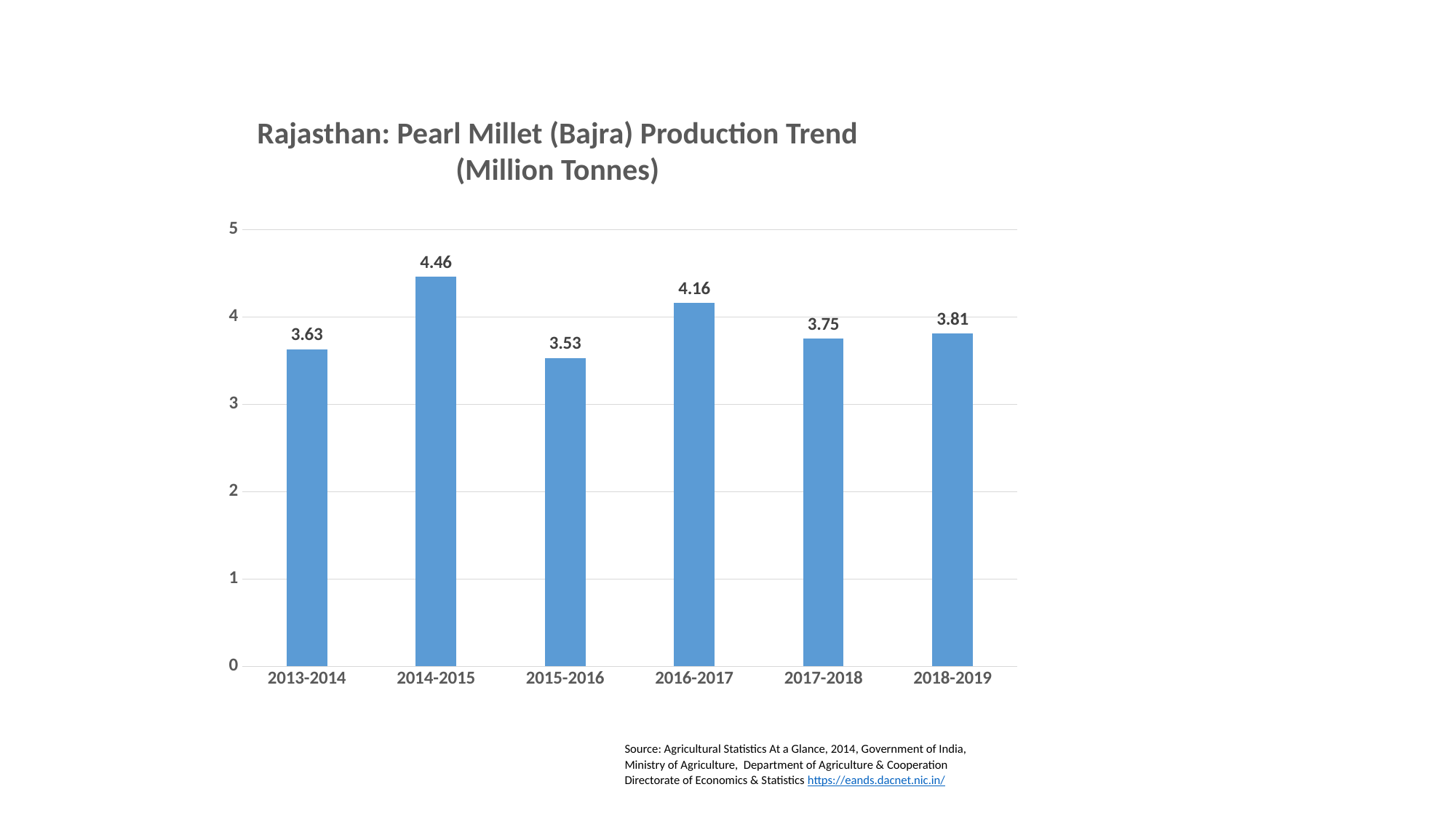
What was Rajasthan's pearl millet production in 2018-2019? 3.81 What kind of chart is shown on the slide? Bar chart Which year had the lowest pearl millet production? 2015-2016 Which year had higher production, 2013-2014 or 2016-2017? 2016-2017 What is the difference in production between 2018-2019 and 2017-2018? 0.06 What unit is production measured in according to the chart title? Million Tonnes Which year had the highest pearl millet production? 2014-2015 Did production rise or fall from 2014-2015 to 2015-2016? Fall Is the value for 2016-2017 greater or less than 4? greater What is the difference in production between 2014-2015 and 2015-2016? 0.93 How many years are shown on the chart? 6 What was Rajasthan's pearl millet production in 2014-2015? 4.46